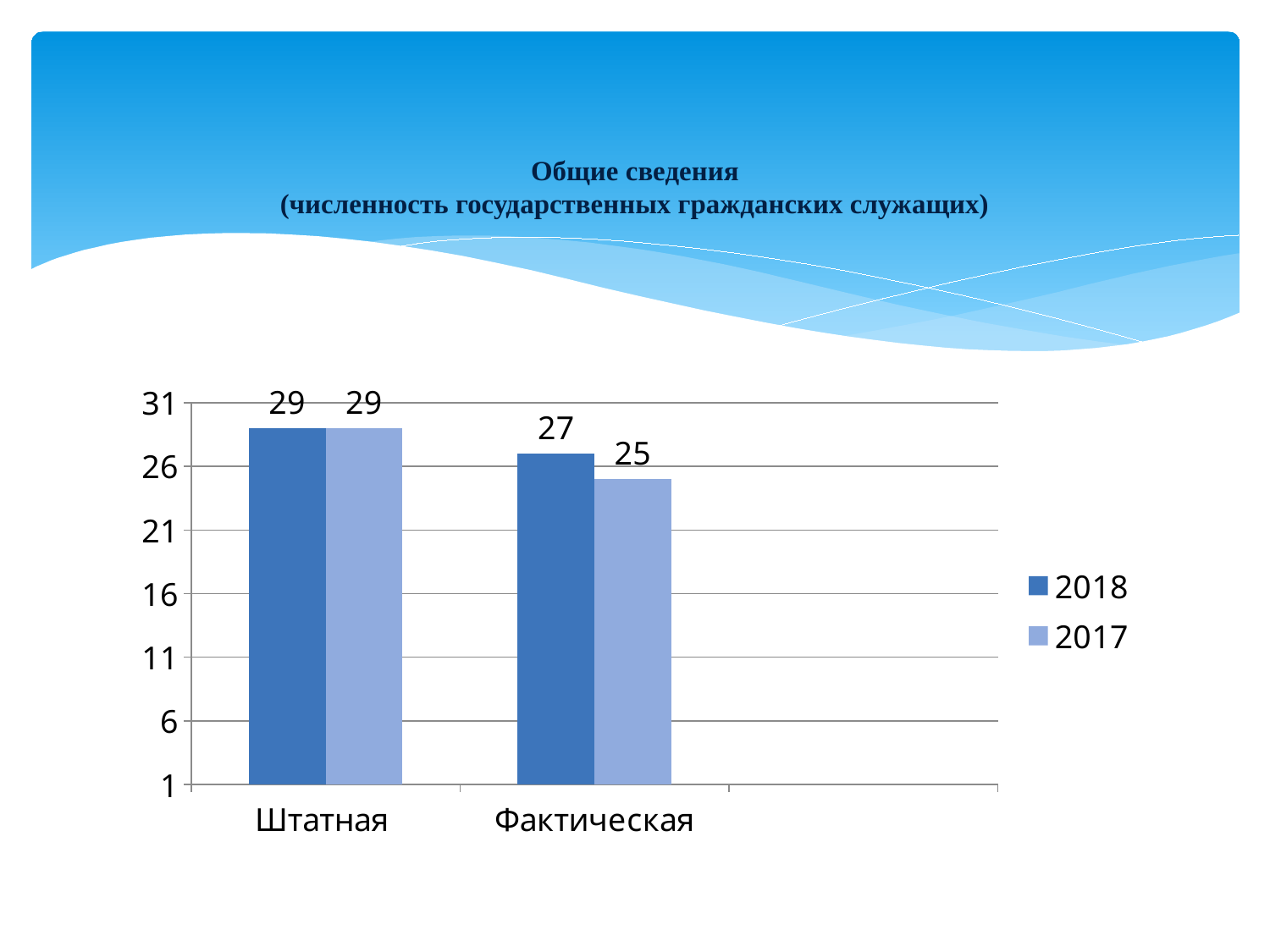
Which is larger for Фактическая: the 2018 value or the 2017 value? 2018 What is the value for Штатная in the 2017 series? 29 Which category has the lowest value in the 2017 series? Фактическая What is the value for Фактическая in the 2018 series? 27 What kind of chart is shown on the slide? bar chart How many series does the legend list? 2 How many categories are shown on the x axis? 2 What is the difference between the Штатная and Фактическая values in the 2018 series? 2 What is the value for Штатная in the 2018 series? 29 What is the difference between the 2018 and 2017 values for Фактическая? 2 What is the value for Фактическая in the 2017 series? 25 Is the value for Фактическая in 2017 greater or less than 21? greater